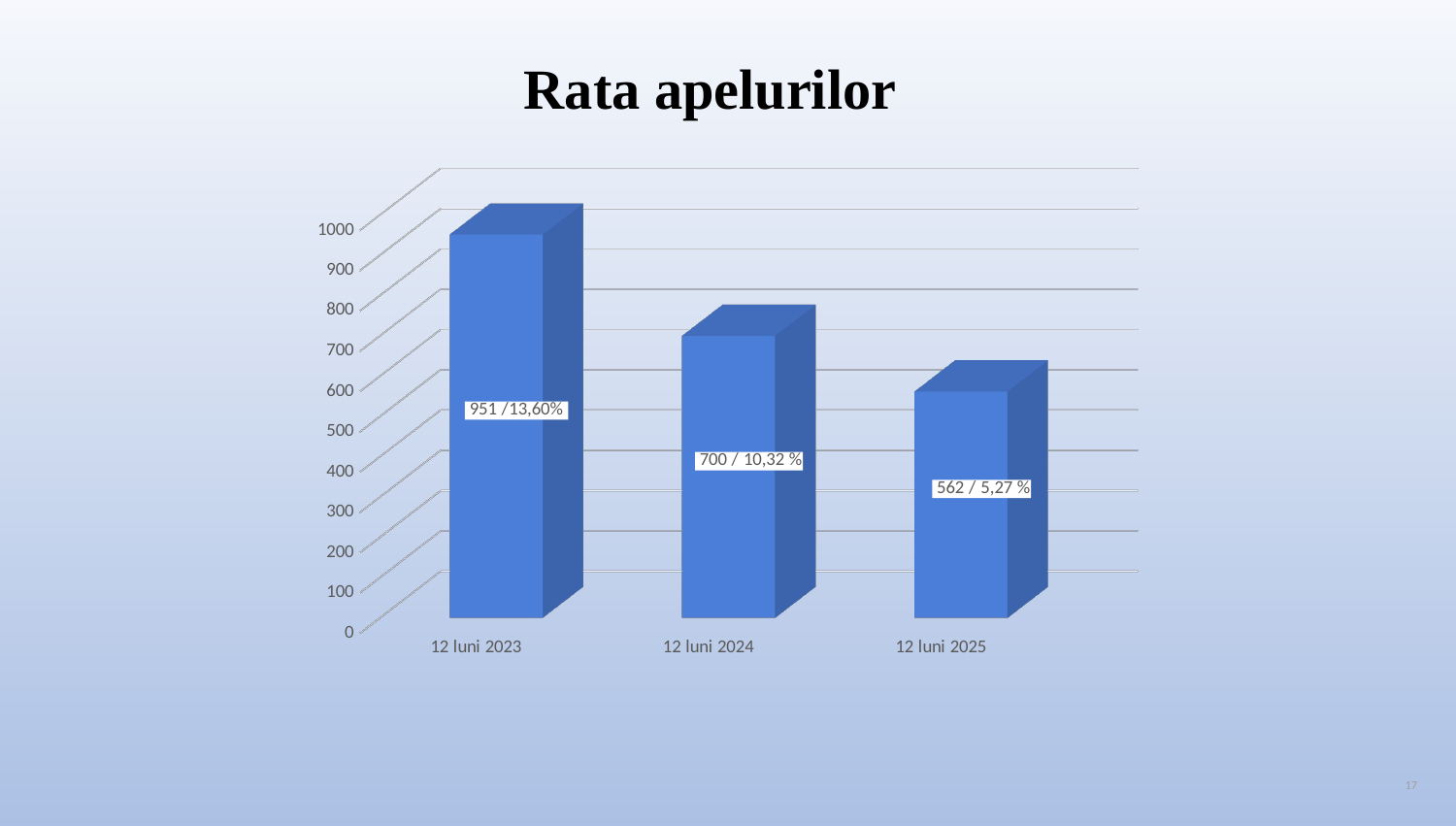
What is the data label shown on the bar for 12 luni 2023? 951 /13,60% Which is larger, the value for 12 luni 2024 or the value for 12 luni 2025? 12 luni 2024 What is the difference between the call counts for 12 luni 2024 and 12 luni 2025? 138 Which category has the lowest bar? 12 luni 2025 What is the data label shown on the bar for 12 luni 2025? 562 / 5,27 % What kind of chart is shown on the slide? Bar chart What is the data label shown on the bar for 12 luni 2024? 700 / 10,32 % What percentage is shown for 12 luni 2024? 10,32 % What is the number of calls shown for 12 luni 2025? 562 What is the difference between the call counts for 12 luni 2023 and 12 luni 2024? 251 Which category has the highest bar? 12 luni 2023 How many categories are shown on the x axis? 3